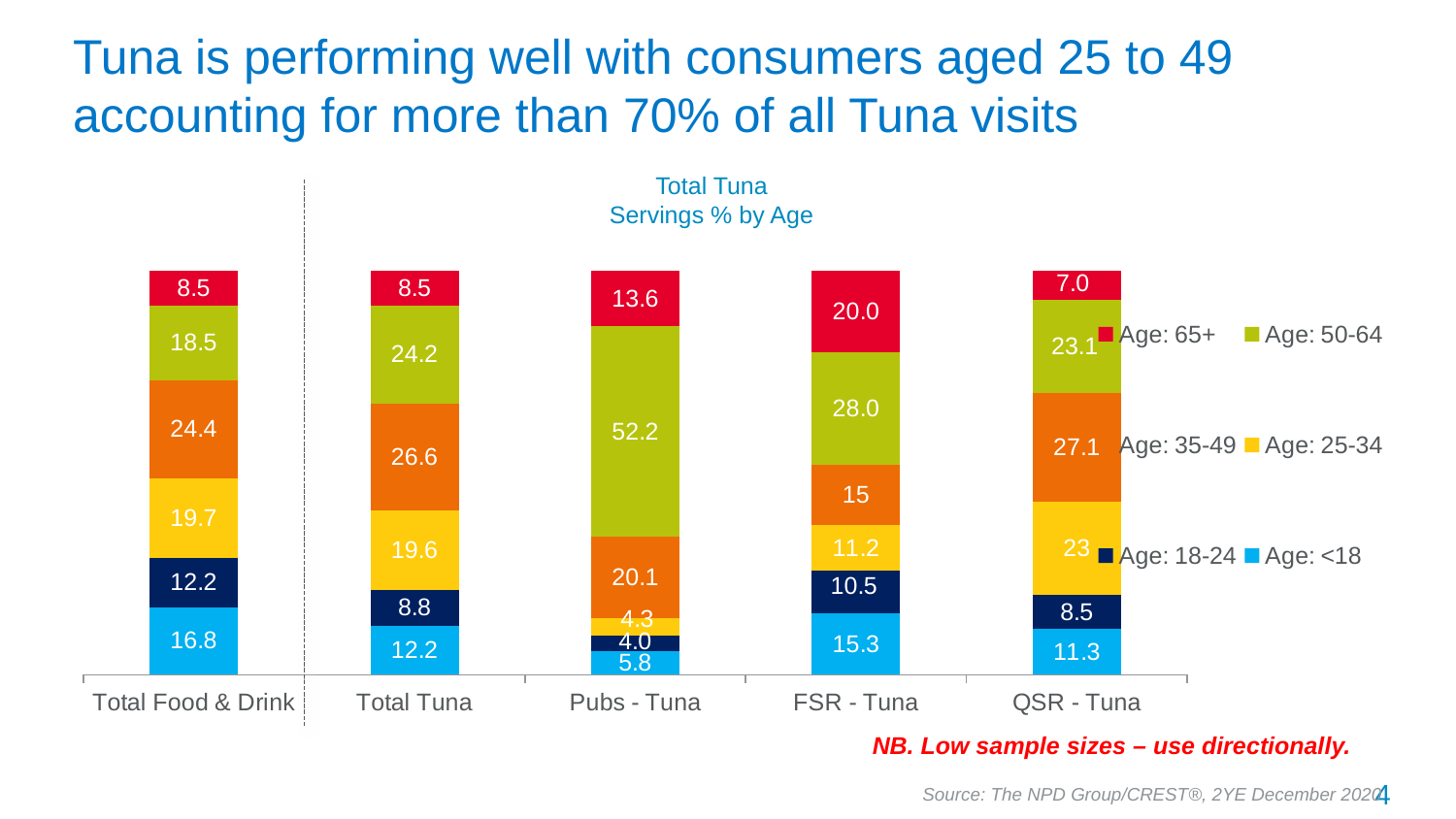
What is the difference between the Age: 35-49 values for Total Tuna and Total Food & Drink? 2.2 How many categories are shown along the x axis of the chart? 5 What is the Age: 50-64 value for Pubs - Tuna? 52.2 What is the Age: <18 value for Total Food & Drink? 16.8 What is the title of the chart? Total Tuna Servings % by Age How many series does the legend list? 6 What is the Age: 35-49 value for QSR - Tuna? 27.1 Which is larger, the Age: 25-34 value for QSR - Tuna or for FSR - Tuna? QSR - Tuna What type of chart is shown on the slide? Stacked bar chart Which category has the lowest Age: 18-24 value? Pubs - Tuna Which category has the highest Age: 50-64 value? Pubs - Tuna What is the Age: 65+ value for FSR - Tuna? 20.0